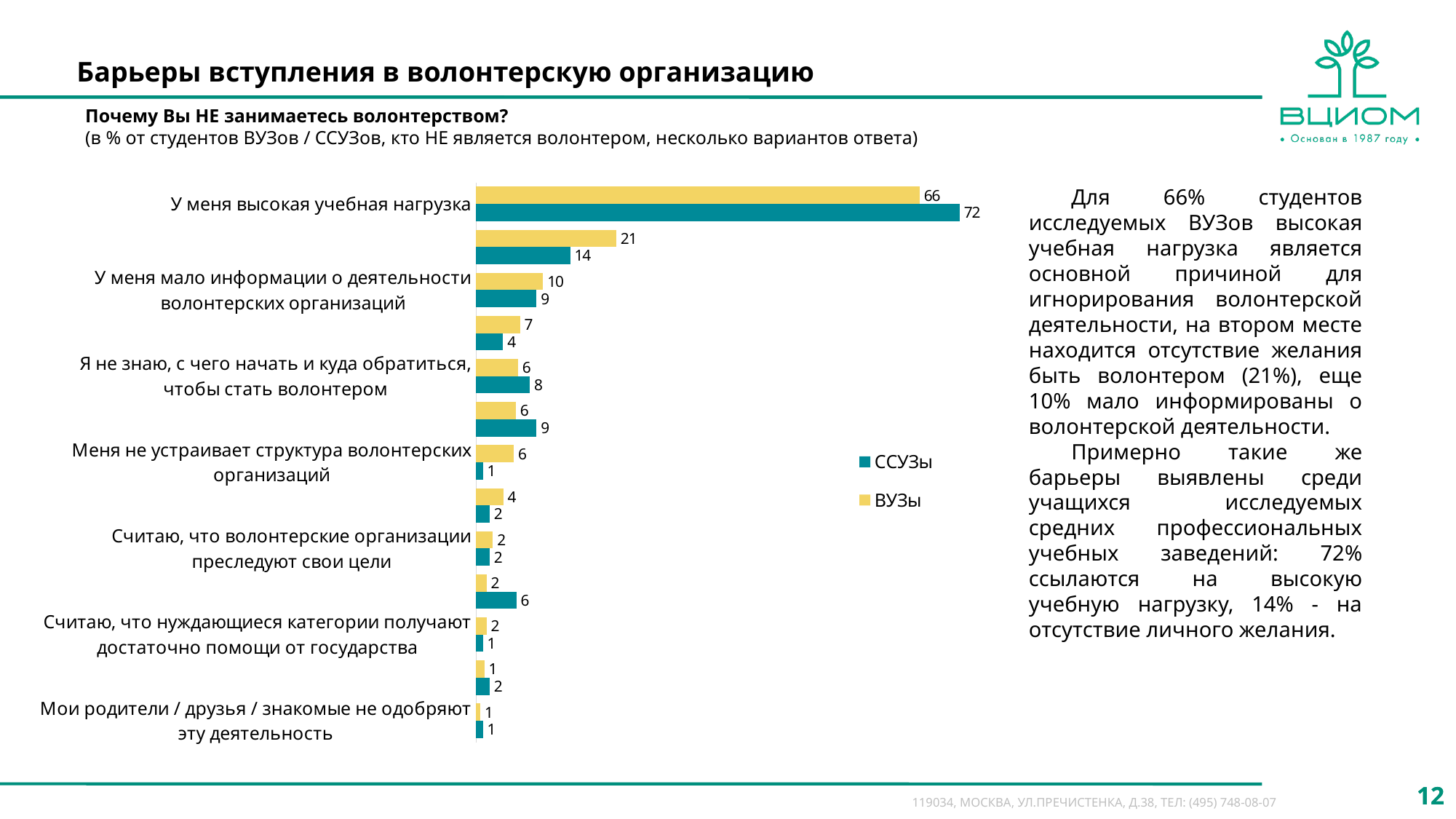
What is the value for ВУЗы for "У меня мало информации о деятельности волонтерских организаций"? 10 How many series does the legend list? 2 For "Меня не устраивает структура волонтерских организаций", which series has the larger value, ССУЗы or ВУЗы? ВУЗы What is the value for ССУЗы for "Я не знаю, с чего начать и куда обратиться, чтобы стать волонтером"? 8 What is the value for ВУЗы for "У меня высокая учебная нагрузка"? 66 What is the difference between the ССУЗы and ВУЗы values for "У меня высокая учебная нагрузка"? 6 How many pairs of bars (categories) are plotted in the chart? 13 What kind of chart is shown on the slide? Bar chart Which category has the highest value for ССУЗы? У меня высокая учебная нагрузка What is the value for ССУЗы for "У меня высокая учебная нагрузка"? 72 What is the value for ССУЗы for "Меня не устраивает структура волонтерских организаций"? 1 Which colour represents ССУЗы in the legend? Teal